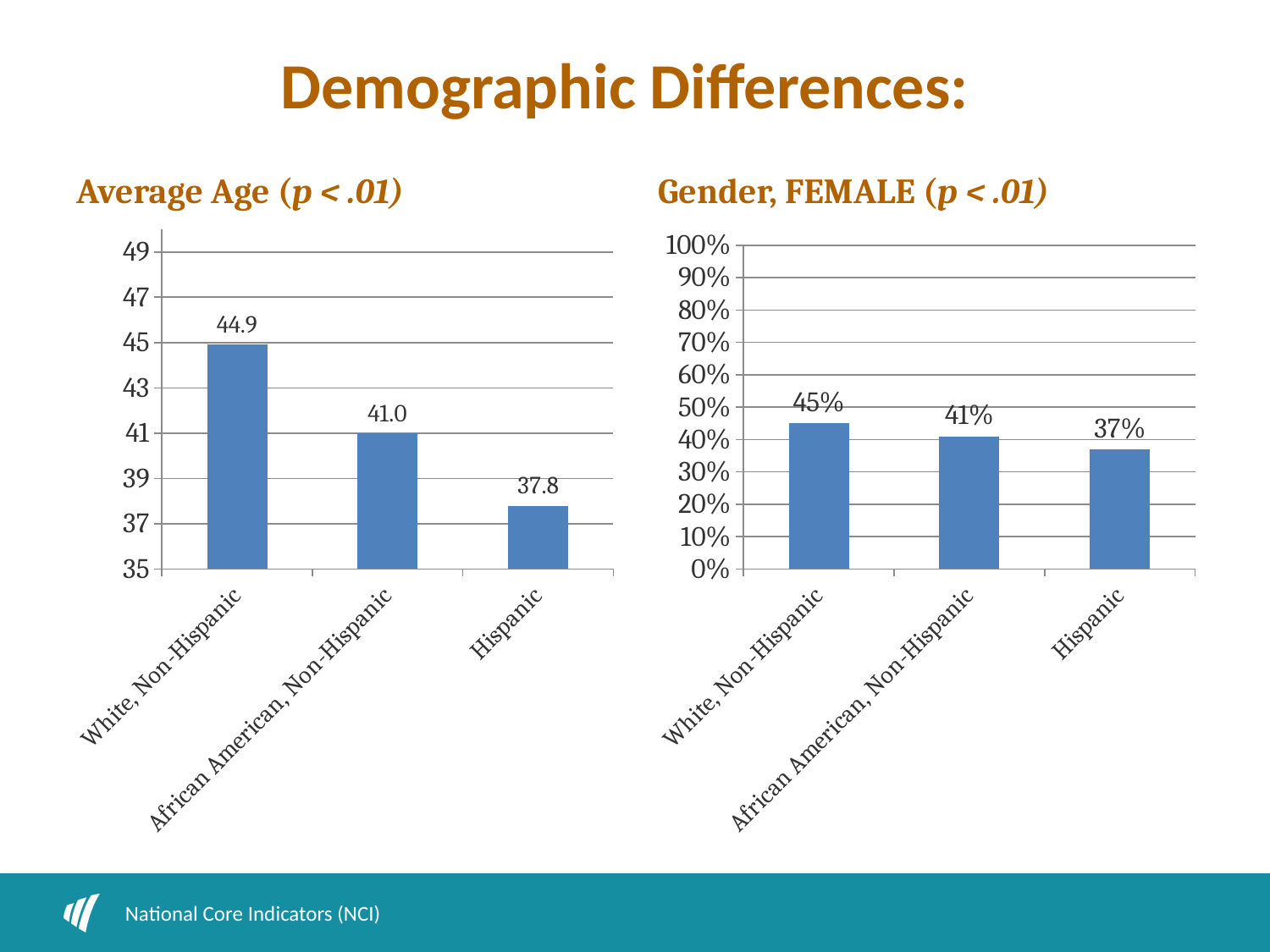
In the Average Age chart, how many categories are shown? 3 In the Average Age chart, what is the difference between the average age for White, Non-Hispanic and African American, Non-Hispanic? 3.9 In the Average Age chart, what is the average age for Hispanic? 37.8 In the Gender, FEMALE chart, which category has the lowest value? Hispanic In the Gender, FEMALE chart, what is the value for Hispanic? 37% In the Gender, FEMALE chart, what is the value for African American, Non-Hispanic? 41% In the Average Age chart, which category has the highest average age? White, Non-Hispanic In the Average Age chart, do the values rise or fall from left to right along the x axis? Fall In the Average Age chart, what is the average age for White, Non-Hispanic? 44.9 In the Gender, FEMALE chart, what is the difference between the values for White, Non-Hispanic and Hispanic? 8% In the Gender, FEMALE chart, which is larger, the value for White, Non-Hispanic or the value for African American, Non-Hispanic? White, Non-Hispanic What kind of chart is the Gender, FEMALE chart? Bar chart